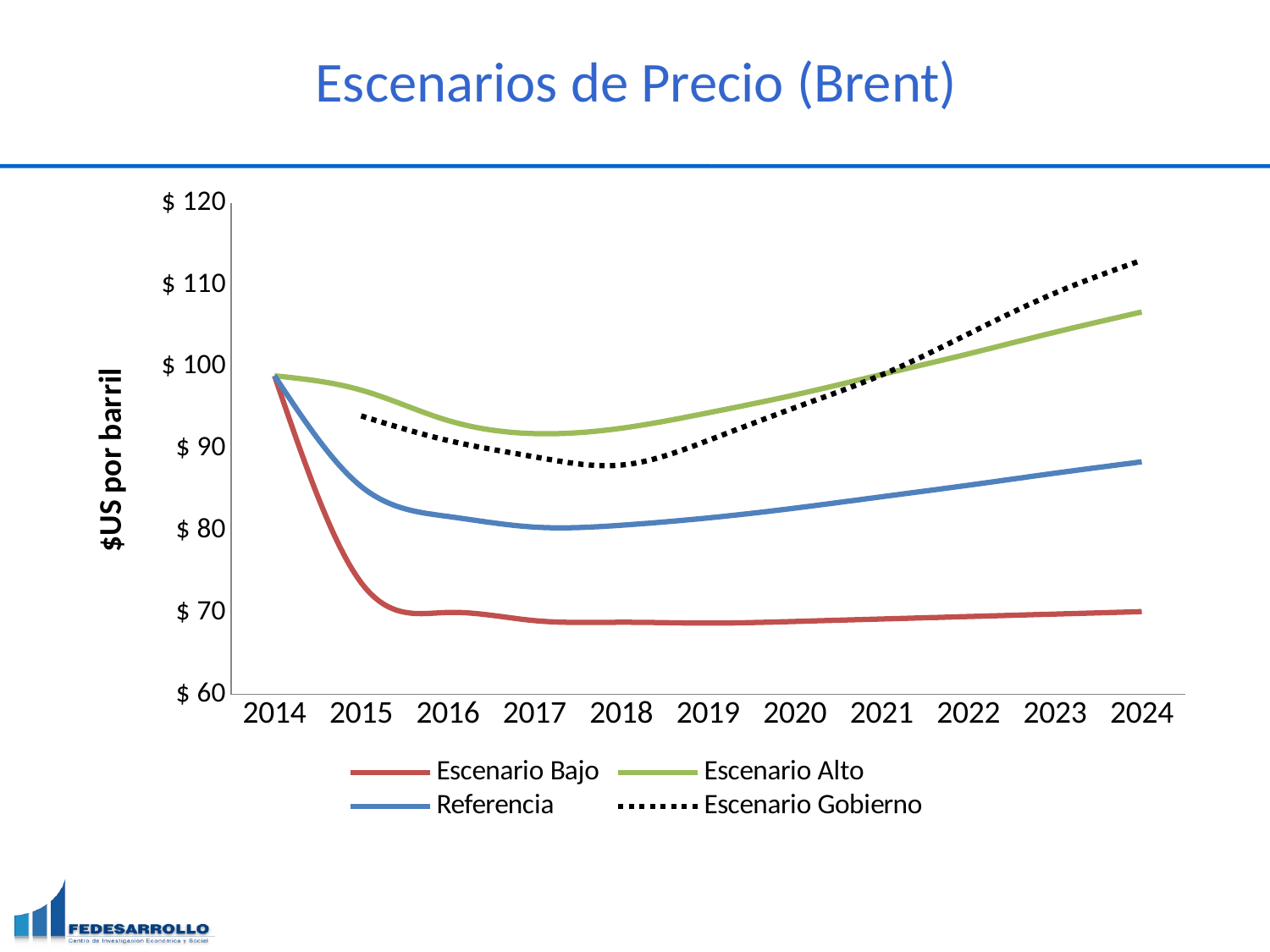
How many series does the legend list? 4 In 2024, which is larger: Escenario Gobierno or Escenario Alto? Escenario Gobierno What is the label of the y axis? $US por barril Does the Escenario Alto series rise or fall from 2018 to 2024? Rise How many years are shown on the x axis? 11 Which series has the highest value in 2024? Escenario Gobierno What kind of chart is shown on the slide? Line chart Does the Escenario Bajo series rise or fall from 2014 to 2017? Fall Is the value for Escenario Alto in 2024 greater or less than $ 100? greater Which series has the lowest value in 2024? Escenario Bajo Is the value for Escenario Bajo in 2024 greater or less than $ 80? less Is the value for Referencia in 2024 greater or less than $ 80? greater